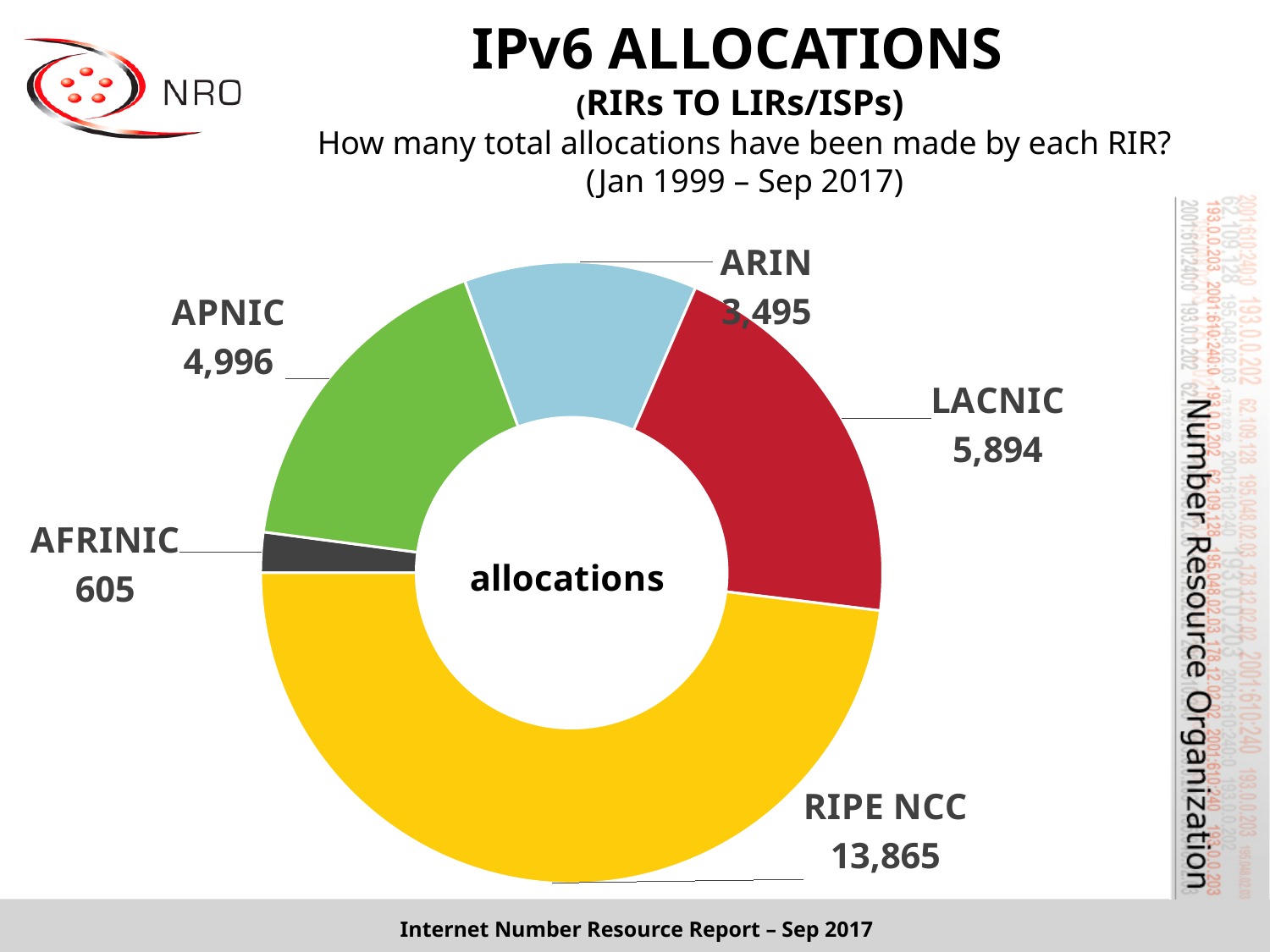
How many RIRs are shown as segments in the chart? 5 What is the value shown for APNIC? 4,996 Which has more allocations, LACNIC or APNIC? LACNIC Which RIR has the largest number of IPv6 allocations? RIPE NCC What is the value shown for AFRINIC? 605 What kind of chart is shown on the slide? Donut (pie) chart How many IPv6 allocations has RIPE NCC made according to the chart? 13,865 What is the value shown for LACNIC? 5,894 What word is printed in the centre of the donut chart? allocations Which RIR has the smallest number of IPv6 allocations? AFRINIC What is the difference between the RIPE NCC and LACNIC allocation counts? 7,971 What is the difference between the APNIC and AFRINIC allocation counts? 4,391